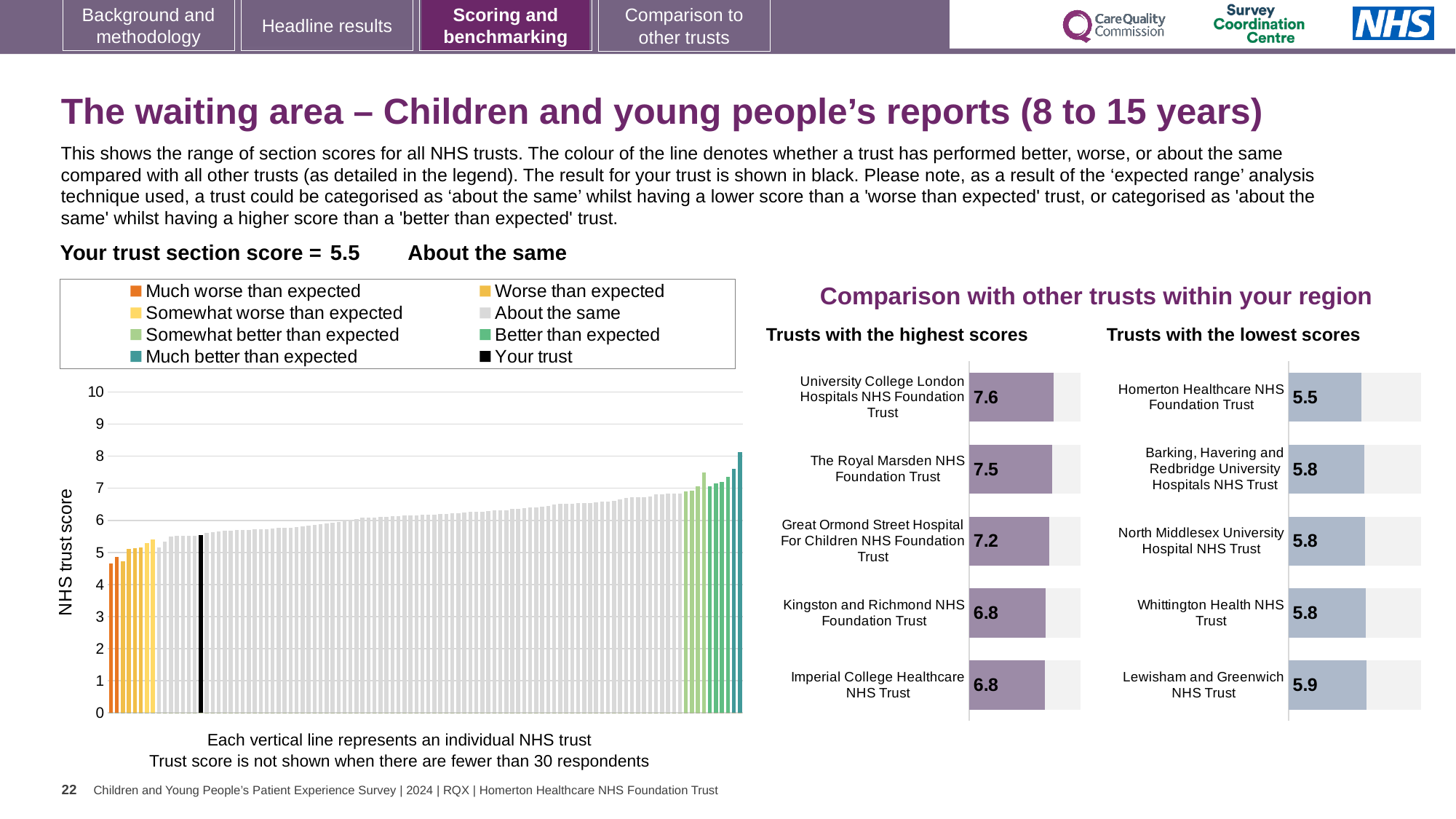
In the 'Trusts with the highest scores' chart, which has the larger score: The Royal Marsden NHS Foundation Trust or Kingston and Richmond NHS Foundation Trust? The Royal Marsden NHS Foundation Trust In the large 'NHS trust score' chart on the left, is the value of the black bar (your trust) greater or less than 6? less In the 'Trusts with the highest scores' chart, which trust has the highest score? University College London Hospitals NHS Foundation Trust In the 'Trusts with the highest scores' chart, what is the score for Great Ormond Street Hospital For Children NHS Foundation Trust? 7.2 How many entries does the legend of the large 'NHS trust score' chart on the left list? 8 In the 'Trusts with the lowest scores' chart, what is the difference between the scores of Lewisham and Greenwich NHS Trust and Homerton Healthcare NHS Foundation Trust? 0.4 How many trusts are listed in the 'Trusts with the lowest scores' chart? 5 In the 'Trusts with the lowest scores' chart, what is the score for Lewisham and Greenwich NHS Trust? 5.9 In the large 'NHS trust score' chart on the left, do the bar values rise or fall from left to right? rise In the 'Trusts with the lowest scores' chart, which trust has the lowest score? Homerton Healthcare NHS Foundation Trust In the 'Trusts with the highest scores' chart, what is the difference between the scores of University College London Hospitals NHS Foundation Trust and Imperial College Healthcare NHS Trust? 0.8 In the 'Trusts with the highest scores' chart, what is the score for University College London Hospitals NHS Foundation Trust? 7.6